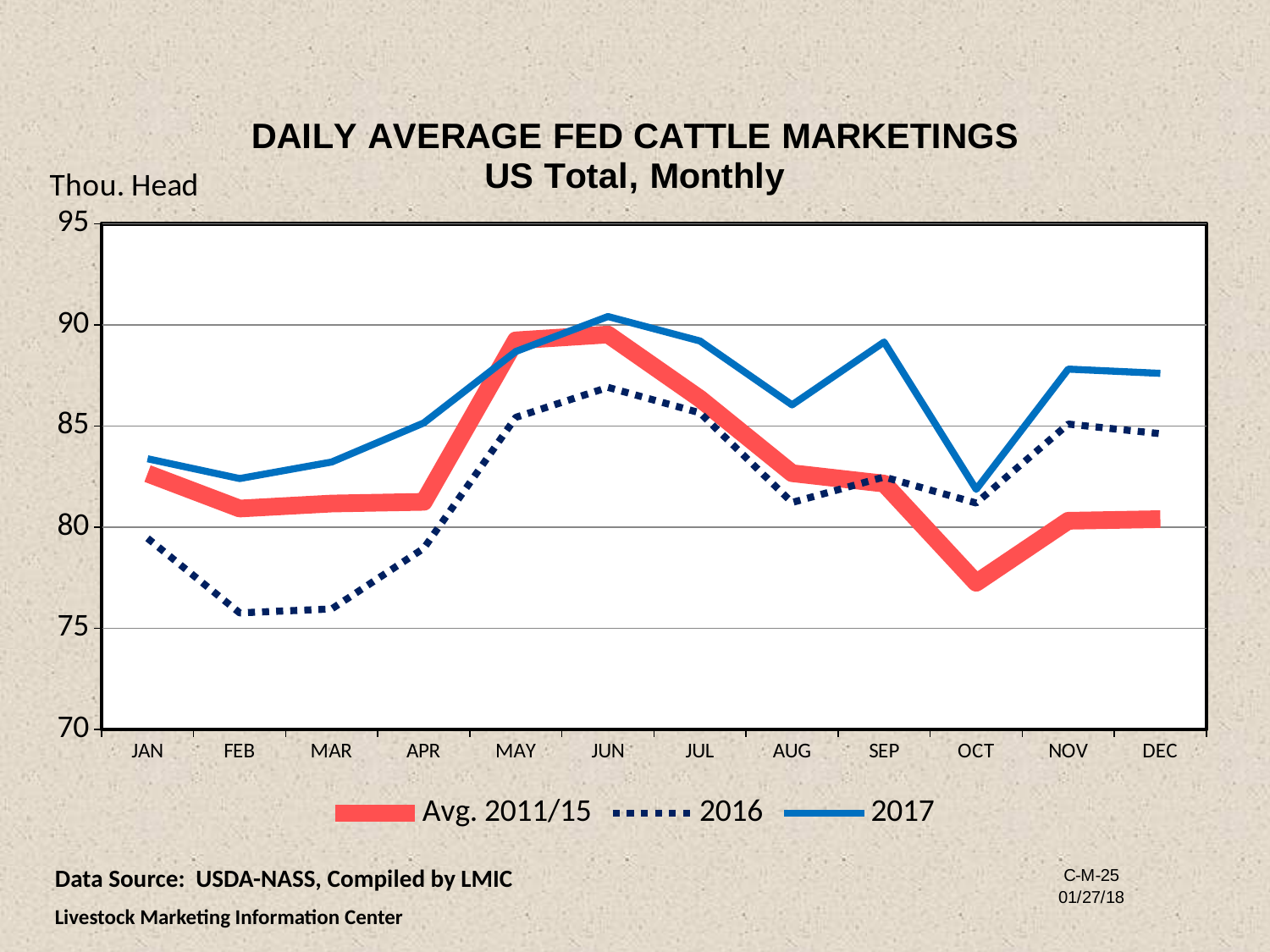
How many months are plotted along the x axis? 12 Is the value for 2017 in JUN greater or less than 90? greater How many series does the legend list? 3 Is the value for 2017 in SEP greater or less than 85? greater What kind of chart is shown on the slide? line chart Is the value for 2016 in FEB greater or less than 80? less Does the 2017 line rise or fall from SEP to OCT? fall In which month does the 2017 line reach its highest value? JUN In which month does the Avg. 2011/15 line reach its lowest value? OCT In JAN, which series has the larger value, 2016 or 2017? 2017 What unit is shown on the y axis label? Thou. Head